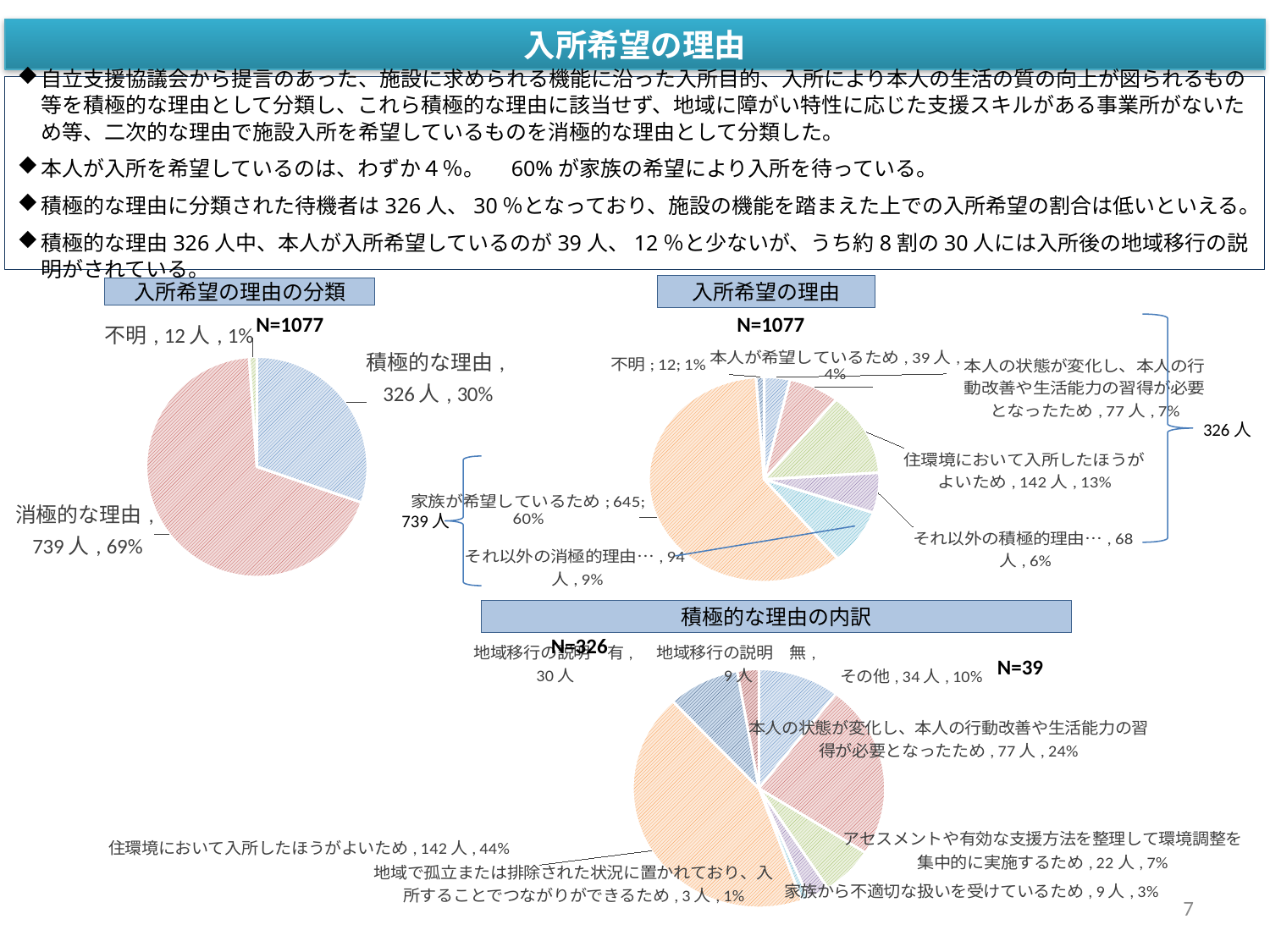
「入所希望の理由の分類」のグラフは何種類のグラフですか？ 円グラフ 「入所希望の理由」のグラフで、最も人数が少ない項目はどれですか？ 不明 「入所希望の理由の分類」のグラフで、消極的な理由の割合は何％ですか？ 69% 「積極的な理由の内訳」のグラフで、アセスメントや有効な支援方法を整理して環境調整を集中的に実施するための人数は何人ですか？ 22人 「入所希望の理由の分類」のグラフで、消極的な理由と積極的な理由の人数の差は何人ですか？ 413人 「入所希望の理由」のグラフで、家族が希望しているための割合は何％ですか？ 60% 「入所希望の理由」のグラフで、本人が希望しているためとそれ以外の積極的理由では、どちらの人数が多いですか？ それ以外の積極的理由 「入所希望の理由の分類」のグラフで、最も割合が大きい分類はどれですか？ 消極的な理由 「入所希望の理由の分類」のグラフで、積極的な理由の人数は何人ですか？ 326人 「入所希望の理由」のグラフで、住環境において入所したほうがよいための人数は何人ですか？ 142人 「積極的な理由の内訳」のグラフで、住環境において入所したほうがよいための割合は何％ですか？ 44% 「積極的な理由の内訳」のグラフのNはいくつですか？ N=326